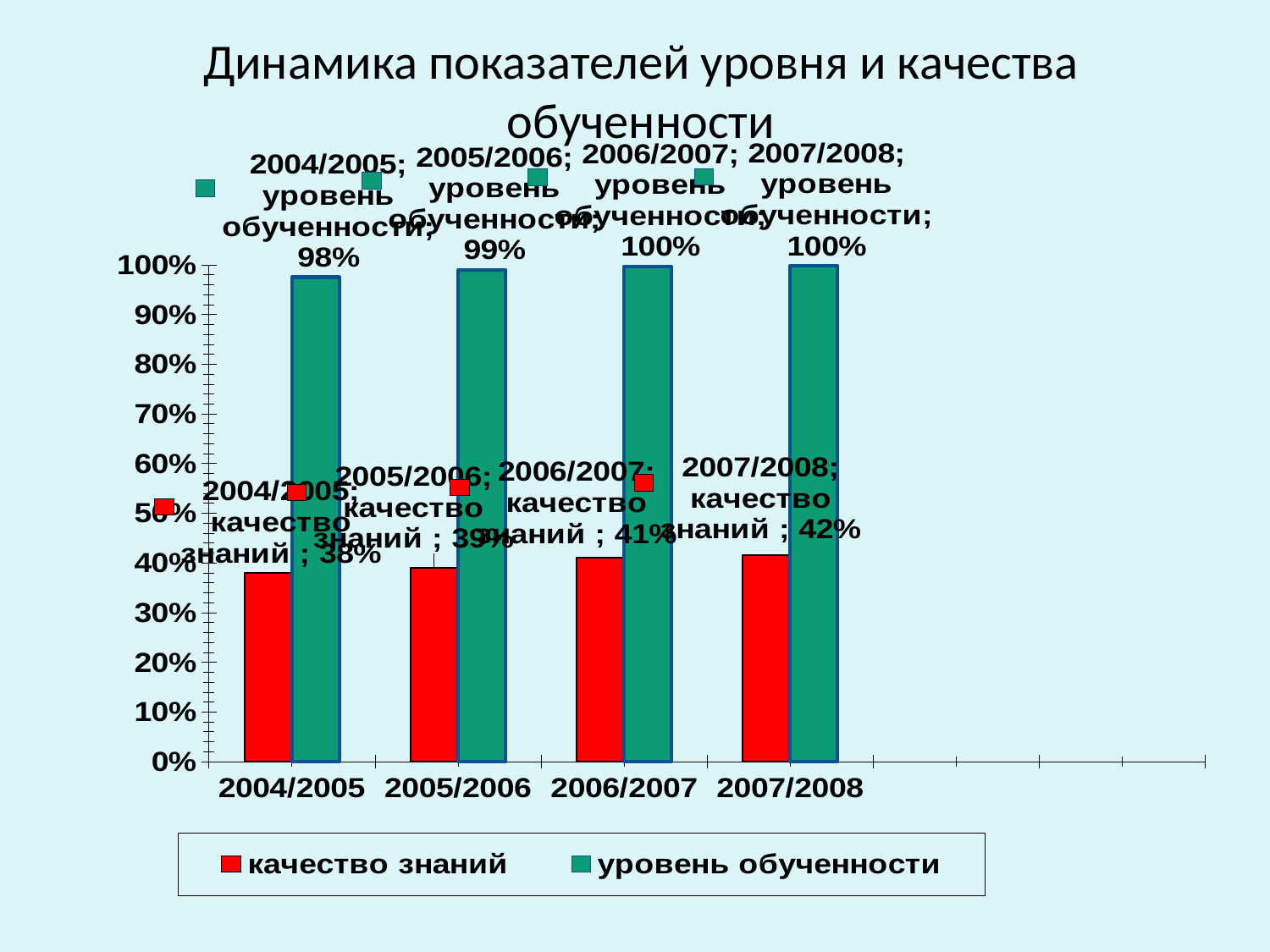
What is the value of 'уровень обученности' for 2004/2005? 98% Which is larger: 'уровень обученности' in 2004/2005 or in 2006/2007? 2006/2007 How many series does the legend list? 2 What is the value of 'уровень обученности' for 2005/2006? 99% In which year is 'качество знаний' the highest? 2007/2008 What is the difference between 'качество знаний' in 2007/2008 and in 2004/2005? 4% What is the value of 'качество знаний' for 2004/2005? 38% What is the value of 'качество знаний' for 2007/2008? 42% How many years (categories) are shown on the x axis? 4 Does 'качество знаний' rise or fall from 2004/2005 to 2007/2008? rise In which year is 'качество знаний' the lowest? 2004/2005 What type of chart is shown on the slide? bar chart